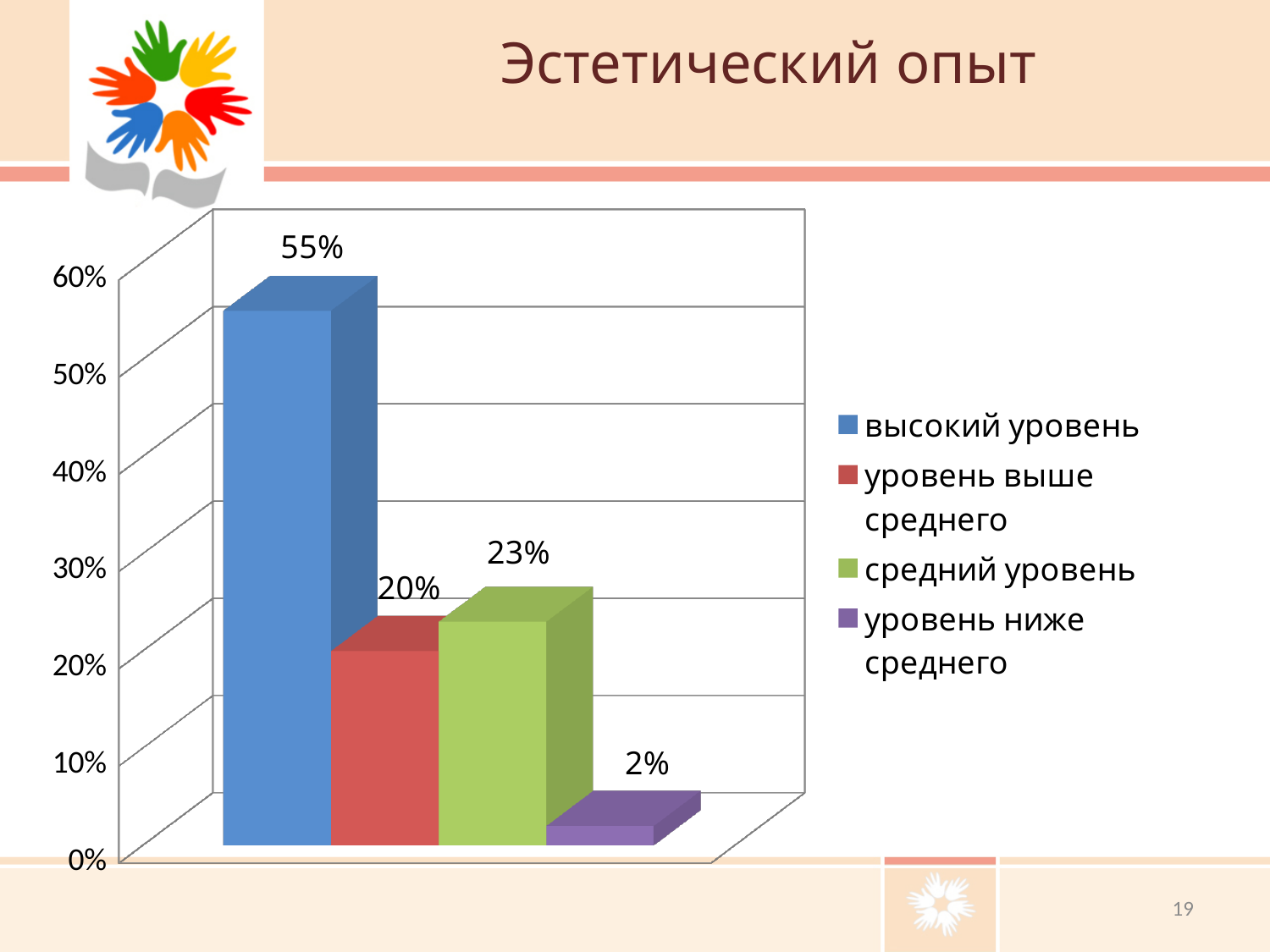
How many series does the legend list? 4 What is the title of the slide containing the chart? Эстетический опыт Which is larger, the value for средний уровень or the value for уровень выше среднего? средний уровень What kind of chart is shown on the slide? bar chart Which category has the highest value? высокий уровень Is the value for высокий уровень greater or less than 50%? greater What is the difference between the values for высокий уровень and средний уровень? 32% What is the value for средний уровень? 23% What is the value for высокий уровень? 55% What is the value for уровень выше среднего? 20% What is the value for уровень ниже среднего? 2% Which category has the lowest value? уровень ниже среднего